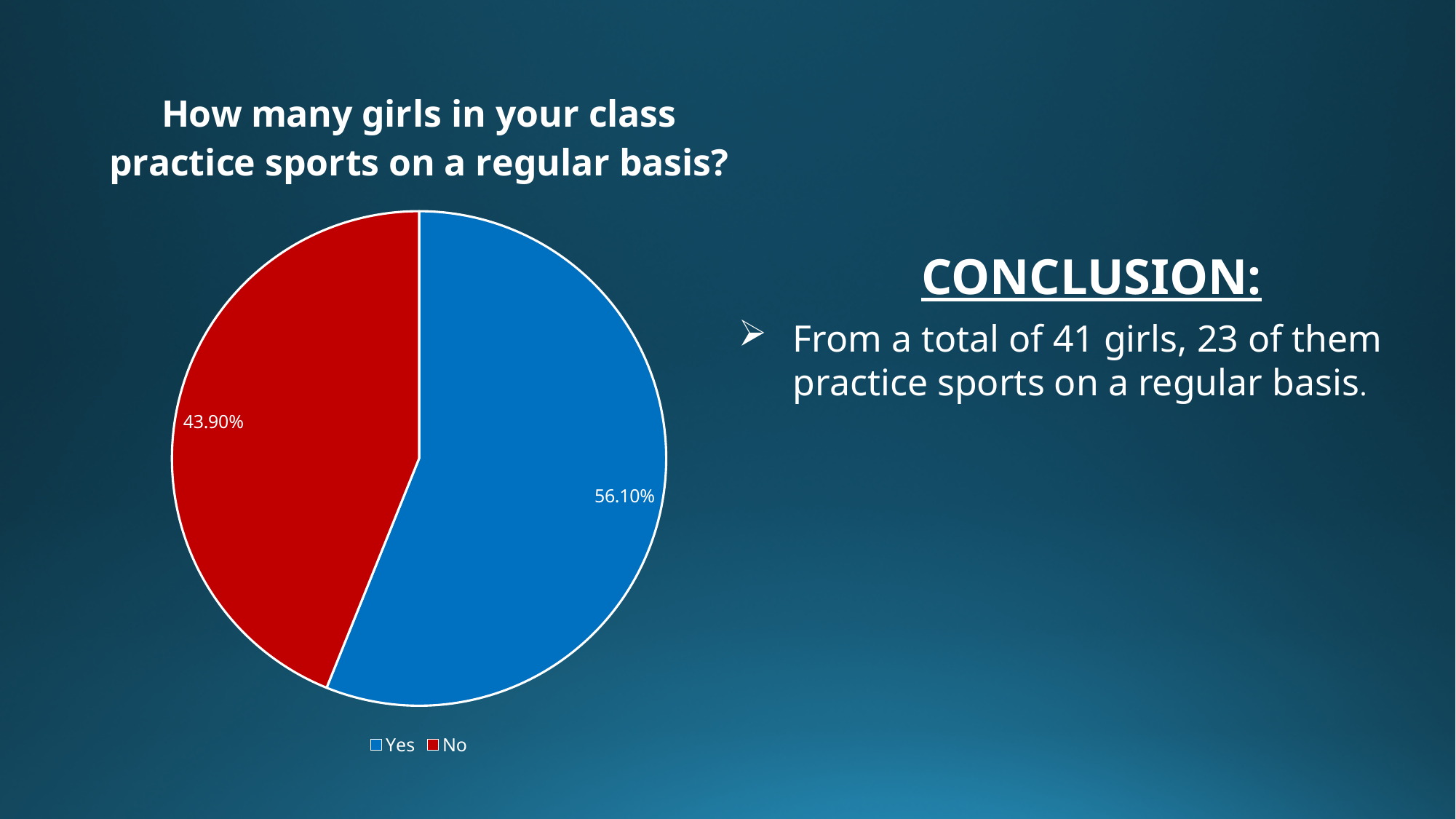
What is the title of the pie chart? How many girls in your class practice sports on a regular basis? What share of the pie does the "No" slice represent? 43.90% What colour is the "No" slice in the pie chart? red What is the difference in percentage points between the "Yes" and "No" slices? 12.20% Which slice of the pie is the largest? Yes How many slices does the pie chart have? 2 What percentage of the pie is labelled for the "No" slice? 43.90% Which slice of the pie is the smallest? No How many entries does the legend list? 2 What percentage of the pie is labelled for the "Yes" slice? 56.10% Which is larger, the "Yes" slice or the "No" slice? Yes What kind of chart is shown on the slide? pie chart